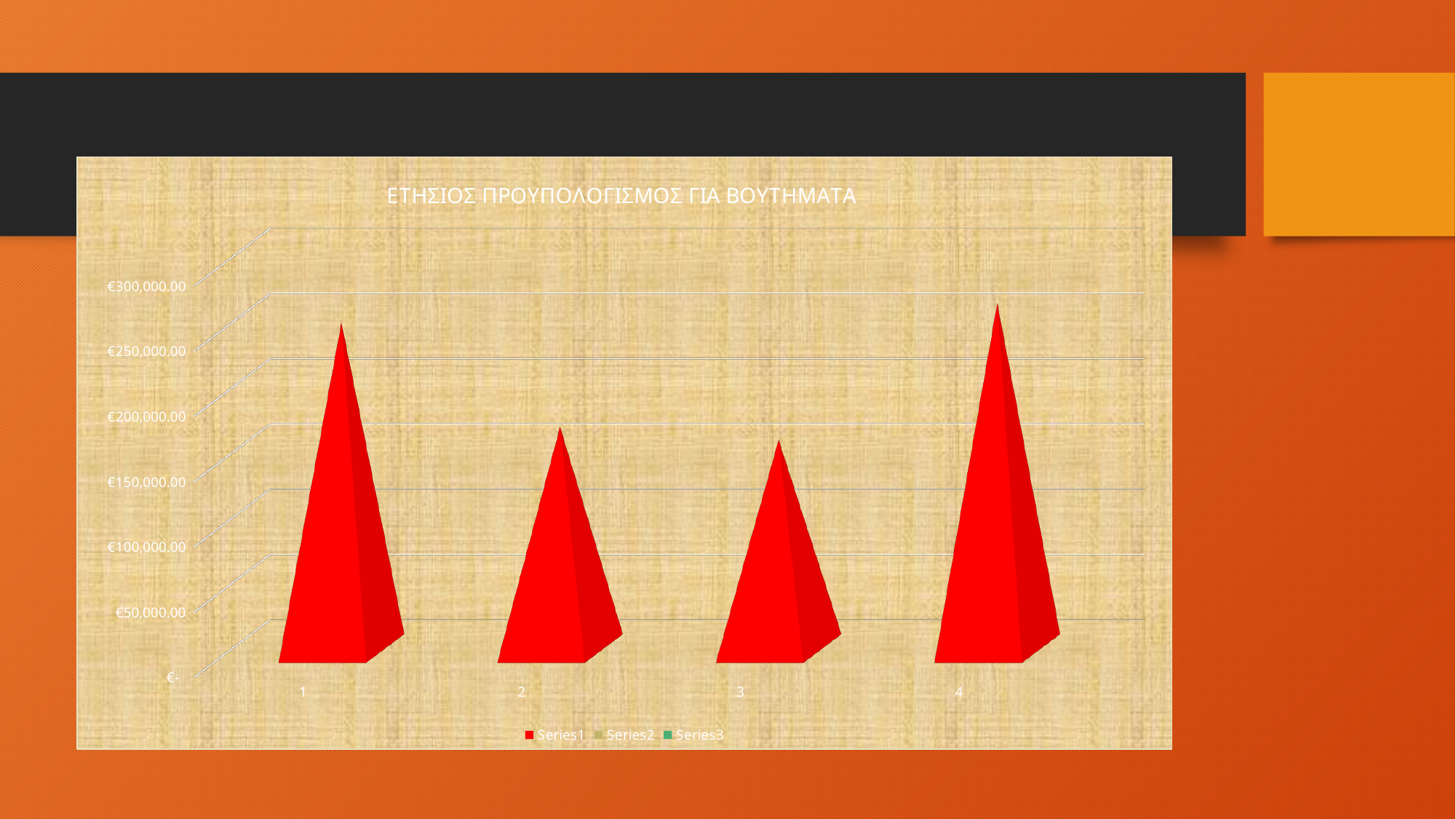
Is the value for category 2 greater or less than €250,000.00? less Which is larger, the value for category 3 or the value for category 4? 4 Is the value for category 3 greater or less than €250,000.00? less Is the value for category 1 greater or less than €200,000.00? greater How many series does the chart legend list? 3 What colour are the bars for Series1 in the chart? red How many categories are shown on the x axis of the chart? 4 Which category has the highest value in the chart? 4 Which is larger, the value for category 1 or the value for category 2? 1 What kind of chart is shown on the slide? bar chart What is the title of the chart? ΕΤΗΣΙΟΣ ΠΡΟΥΠΟΛΟΓΙΣΜΟΣ ΓΙΑ ΒΟΥΤΗΜΑΤΑ